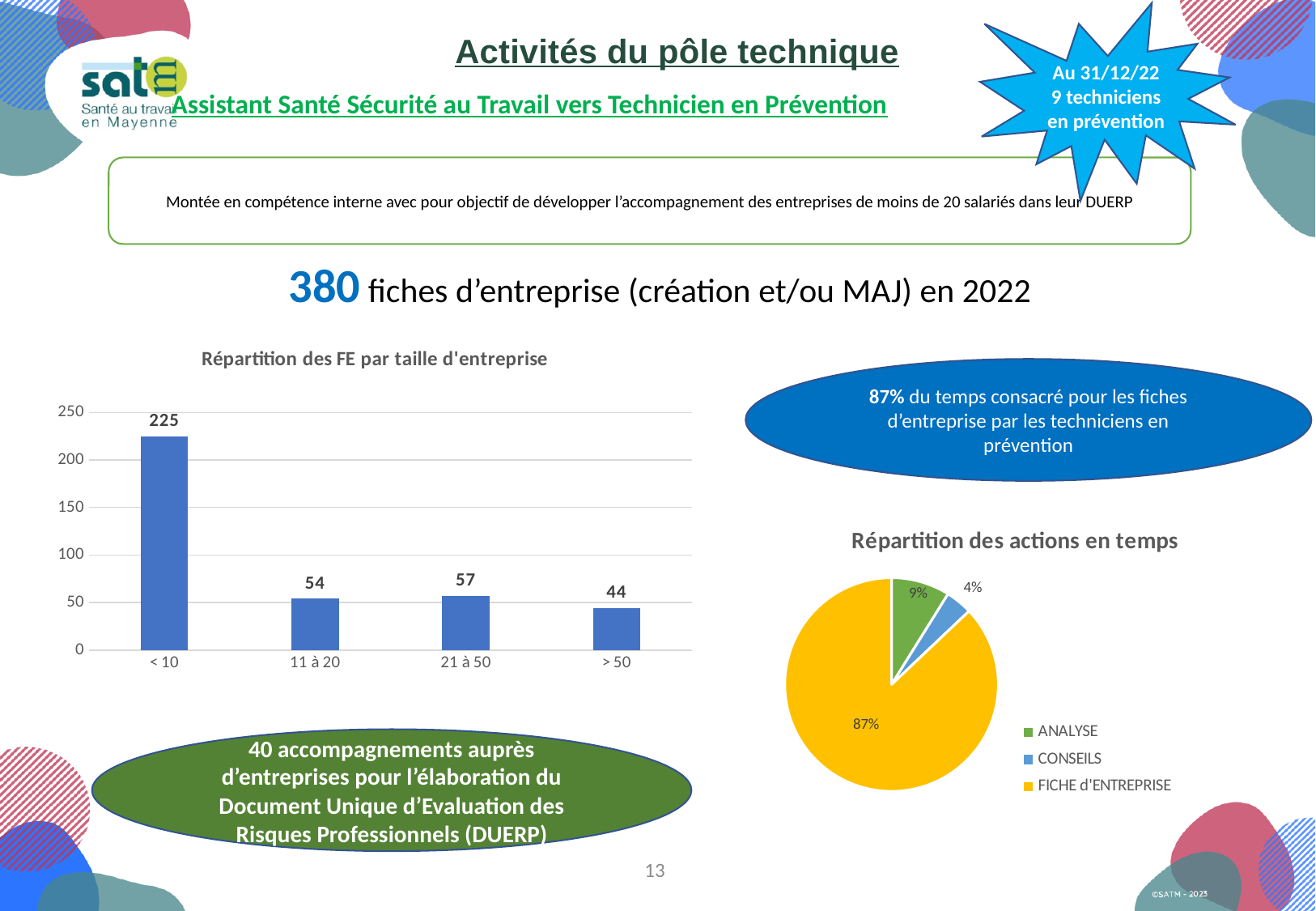
In the chart 'Répartition des FE par taille d'entreprise', what is the value for '11 à 20'? 54 In the chart 'Répartition des FE par taille d'entreprise', which category has the highest value? < 10 How many categories are shown in the chart 'Répartition des FE par taille d'entreprise'? 4 In the chart 'Répartition des FE par taille d'entreprise', what is the value for '< 10'? 225 In the chart 'Répartition des FE par taille d'entreprise', what is the difference between the values for '< 10' and '21 à 50'? 168 What kind of chart is 'Répartition des FE par taille d'entreprise'? bar chart In the chart 'Répartition des FE par taille d'entreprise', which category has the lowest value? > 50 In the chart 'Répartition des actions en temps', what share does 'FICHE d'ENTREPRISE' have? 87% In the chart 'Répartition des FE par taille d'entreprise', what is the value for '> 50'? 44 In the chart 'Répartition des FE par taille d'entreprise', which is larger, the value for '11 à 20' or '21 à 50'? 21 à 50 How many entries does the legend of the chart 'Répartition des actions en temps' list? 3 In the chart 'Répartition des actions en temps', what share does 'ANALYSE' have? 9%